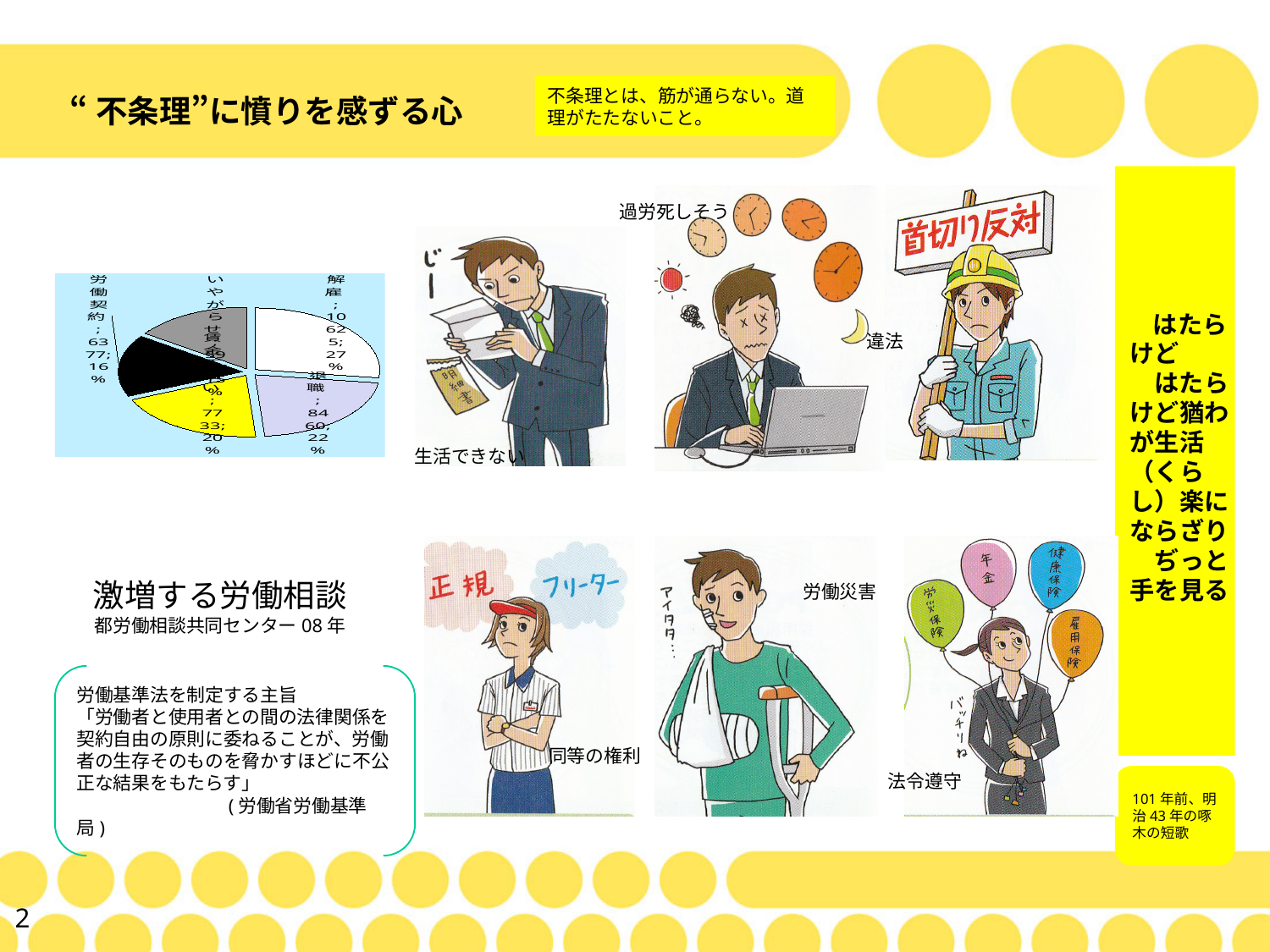
What heading is printed below the pie chart? 激増する労働相談 In the pie chart, what percentage is shown for 退職? 22% How many slices does the pie chart have? 5 In the pie chart, what value is shown for 解雇? 10625 In the pie chart, what value is shown for 労働契約? 6377 What kind of chart is shown on the left of the slide? pie chart In the pie chart, what value is shown for 退職? 8460 In the pie chart, what is the difference between the values for 解雇 and 退職? 2165 Which category has the largest share in the pie chart? 解雇 In the pie chart, what percentage is shown for 労働契約? 16% In the pie chart, which is larger, 解雇 or 退職? 解雇 In the pie chart, what percentage is shown for 解雇? 27%